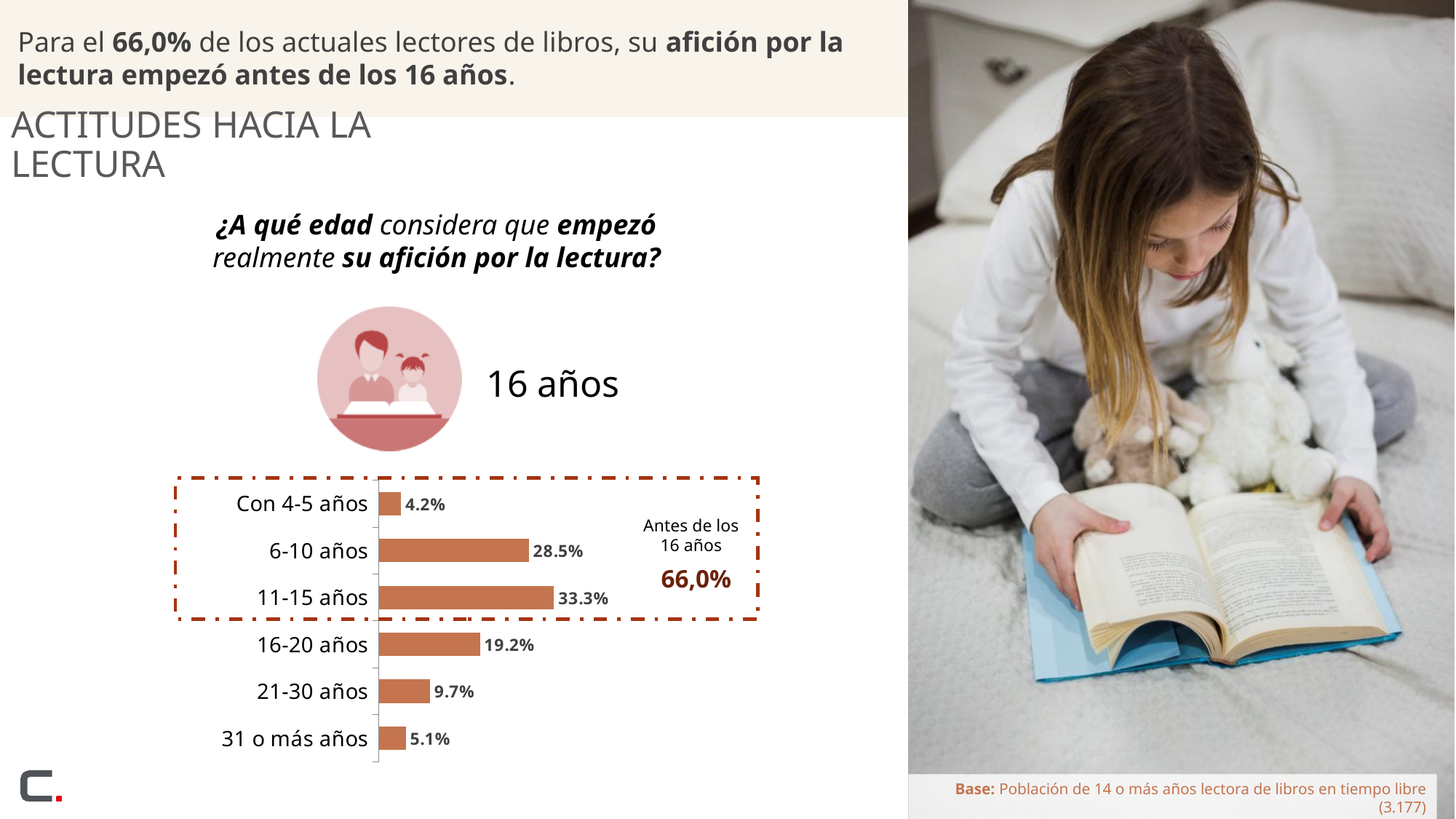
What is the value for the '6-10 años' category? 28.5% What is the value for the '16-20 años' category? 19.2% What is the difference between the values for '16-20 años' and '21-30 años'? 9.5% What question does the chart answer, according to the text above it? ¿A qué edad considera que empezó realmente su afición por la lectura? Which is larger, the value for '21-30 años' or the value for '31 o más años'? 21-30 años Which age category has the highest value? 11-15 años What is the combined share for the categories grouped as 'Antes de los 16 años'? 66,0% How many age categories are shown in the chart? 6 What kind of chart is shown on the slide? Bar chart What is the value for the '31 o más años' category? 5.1% What is the difference between the values for '11-15 años' and '6-10 años'? 4.8% Which age category has the lowest value? Con 4-5 años